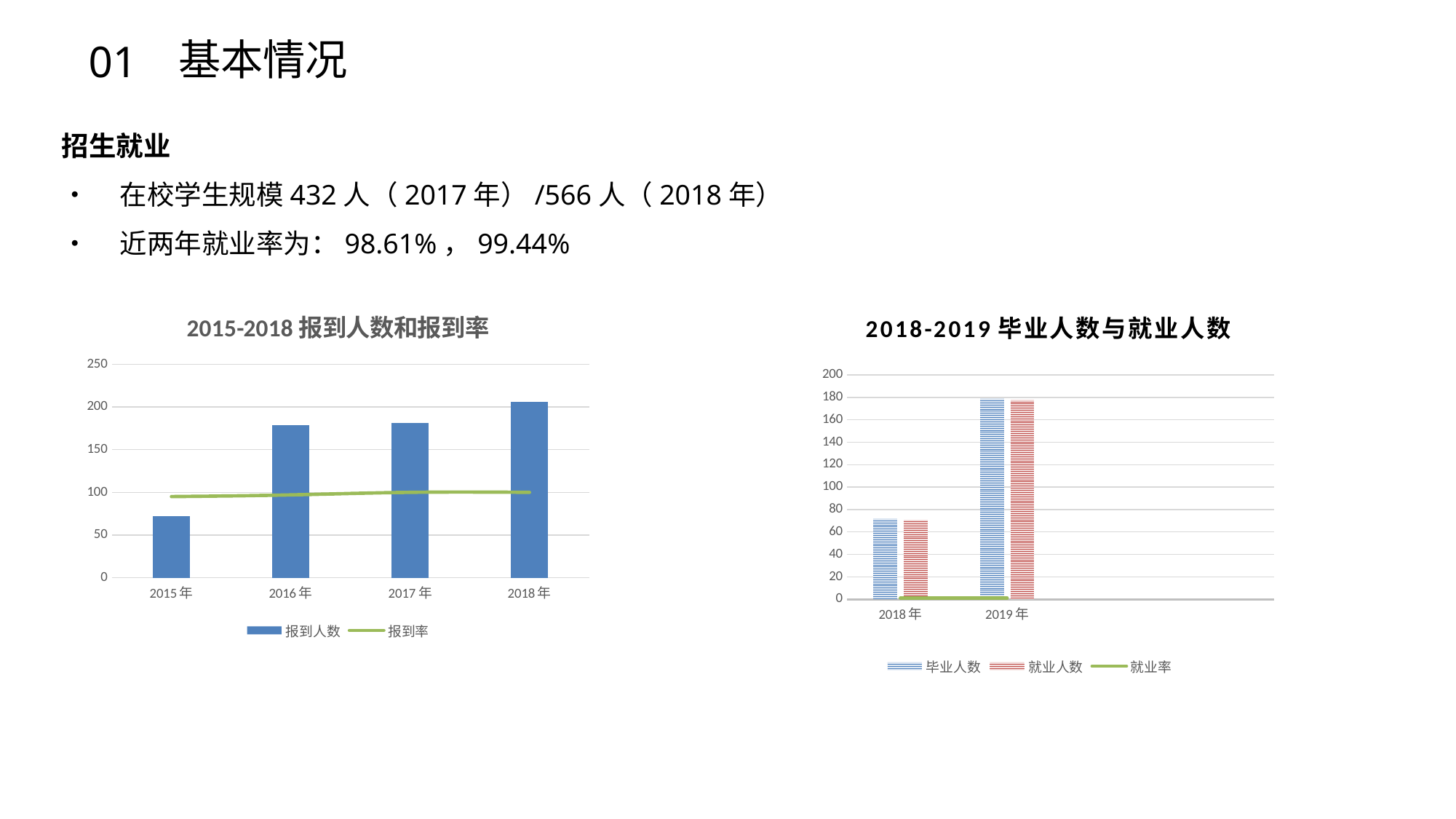
In the chart titled 2018-2019 毕业人数与就业人数, which year has the higher 毕业人数? 2019 年 In the chart titled 2015-2018 报到人数和报到率, is the 报到人数 for 2015 年 greater or less than 100? less In the chart titled 2015-2018 报到人数和报到率, how many series does the legend list? 2 In the chart titled 2015-2018 报到人数和报到率, is the 报到人数 for 2016 年 greater or less than 150? greater In the chart titled 2018-2019 毕业人数与就业人数, what colour are the 就业人数 bars? red In the chart titled 2015-2018 报到人数和报到率, which is larger, the 报到人数 for 2015 年 or for 2018 年? 2018 年 In the chart titled 2018-2019 毕业人数与就业人数, is the 就业人数 for 2018 年 greater or less than 80? less In the chart titled 2015-2018 报到人数和报到率, how many years are shown on the x axis? 4 In the chart titled 2015-2018 报到人数和报到率, which year has the lowest 报到人数? 2015 年 In the chart titled 2015-2018 报到人数和报到率, which year has the highest 报到人数? 2018 年 In the chart titled 2018-2019 毕业人数与就业人数, how many series does the legend list? 3